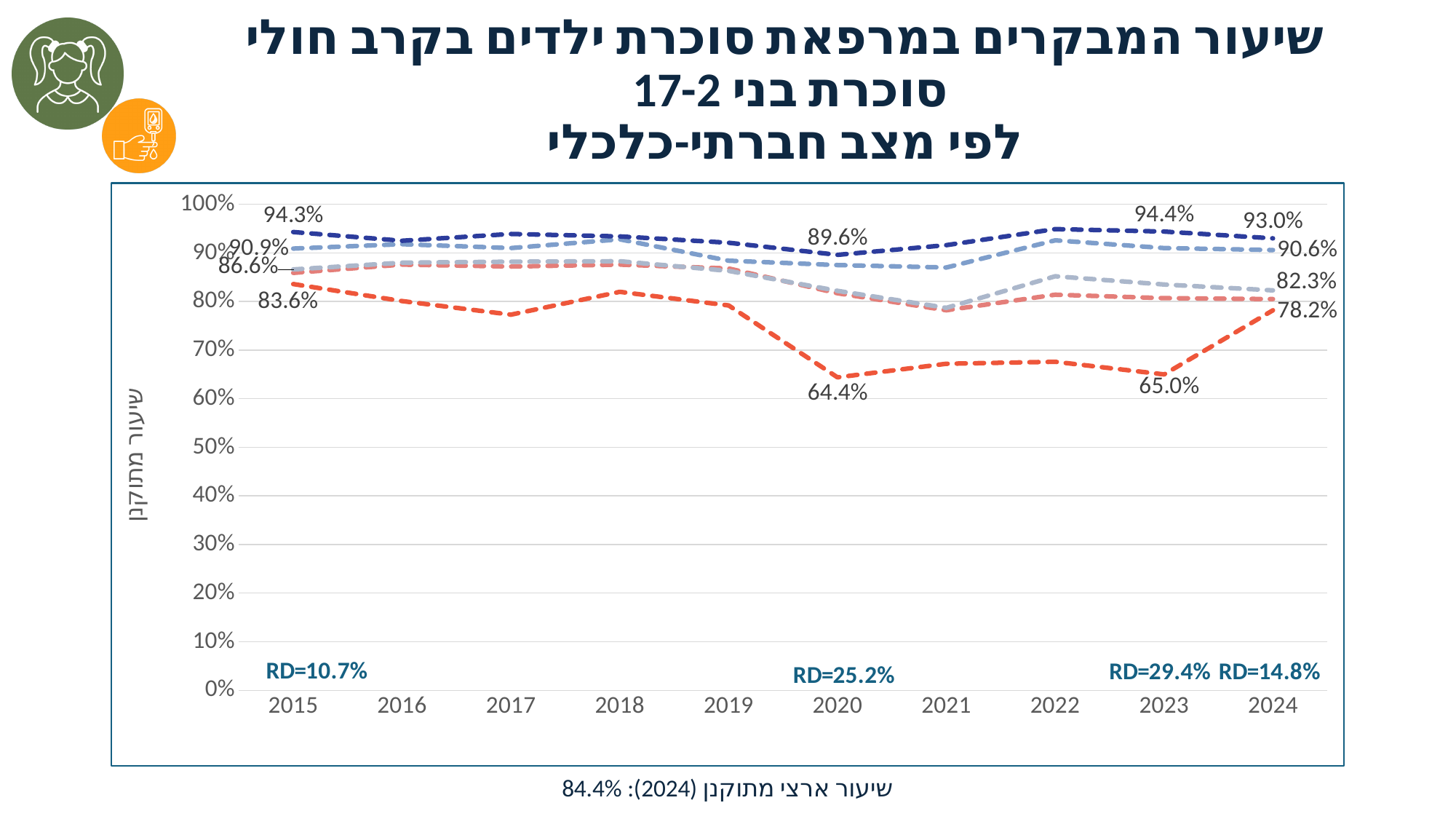
What is the labelled value of the top (dark blue) line in 2024? 93.0% Is the value of the lowest (red) line in 2021 greater or less than 70%? less What kind of chart is shown on the slide? line chart Which is larger for the top (dark blue) line: its value in 2023 or in 2024? 2023 What is the labelled value of the lowest (red) line in 2023? 65.0% Which year has the largest RD value printed on the chart? 2023 What is the difference between the top line's value (94.3%) and the lowest line's value (83.6%) in 2015? 10.7% What is the labelled value of the lowest (red) line in 2020? 64.4% How many years are shown on the x axis of the chart? 10 What is the labelled value of the top (dark blue) line in 2015? 94.3% What is the difference between the top line's value (93.0%) and the lowest line's value (78.2%) in 2024? 14.8% What national rate for 2024 is printed below the chart? 84.4%